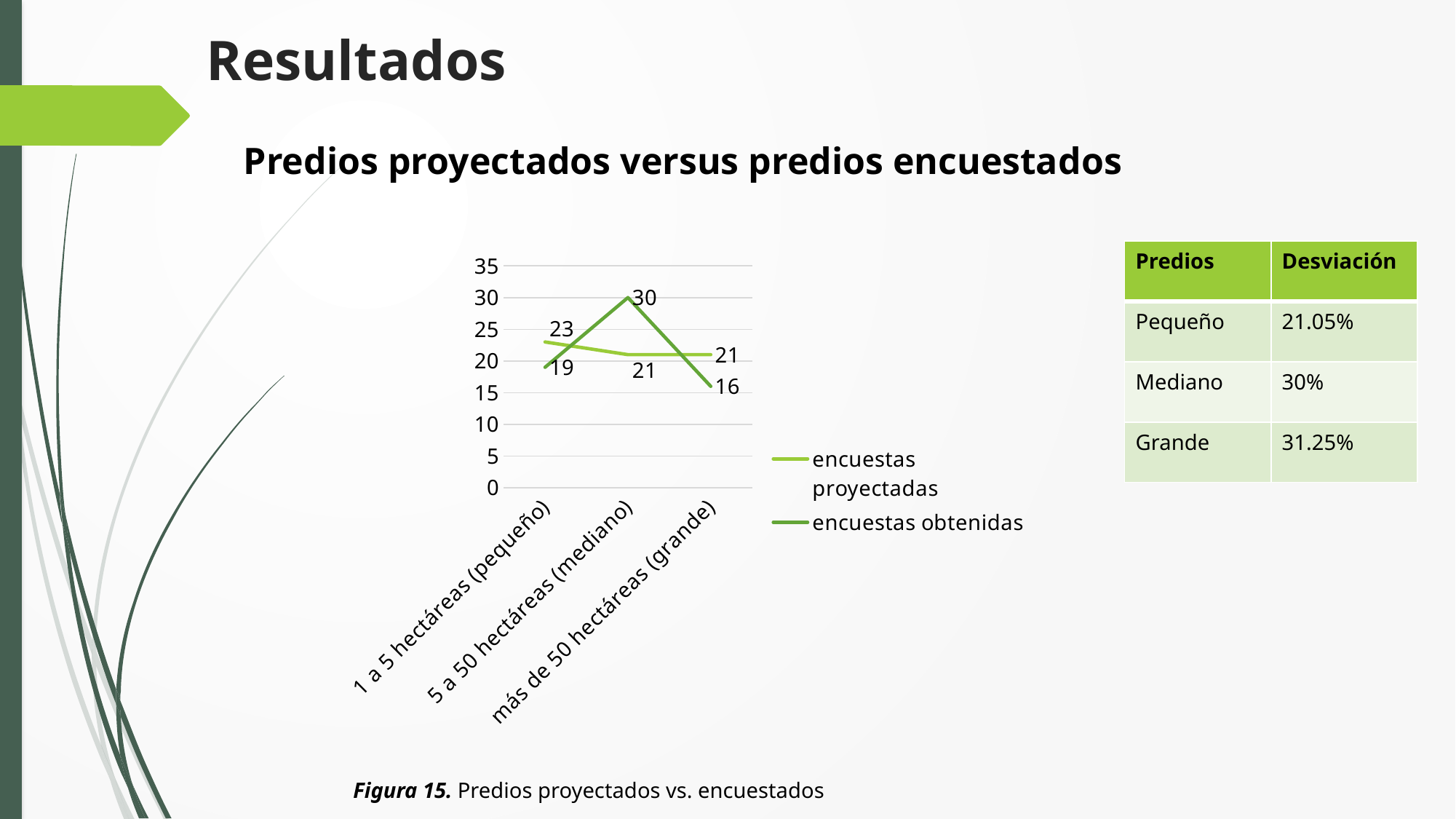
Does the encuestas proyectadas series rise or fall from 1 a 5 hectáreas (pequeño) to 5 a 50 hectáreas (mediano)? fall How many series does the chart legend list? 2 Which category has the lowest value for encuestas obtenidas? más de 50 hectáreas (grande) What is the value of encuestas obtenidas for más de 50 hectáreas (grande)? 16 How many categories are shown on the x axis of the chart? 3 What is the difference between encuestas obtenidas and encuestas proyectadas for 5 a 50 hectáreas (mediano)? 9 What is the value of encuestas proyectadas for 1 a 5 hectáreas (pequeño)? 23 What type of chart is shown on the slide? line chart What is the caption of the figure below the chart? Figura 15. Predios proyectados vs. encuestados For más de 50 hectáreas (grande), which is larger: encuestas proyectadas or encuestas obtenidas? encuestas proyectadas Which category has the highest value for encuestas obtenidas? 5 a 50 hectáreas (mediano) What is the value of encuestas obtenidas for 5 a 50 hectáreas (mediano)? 30